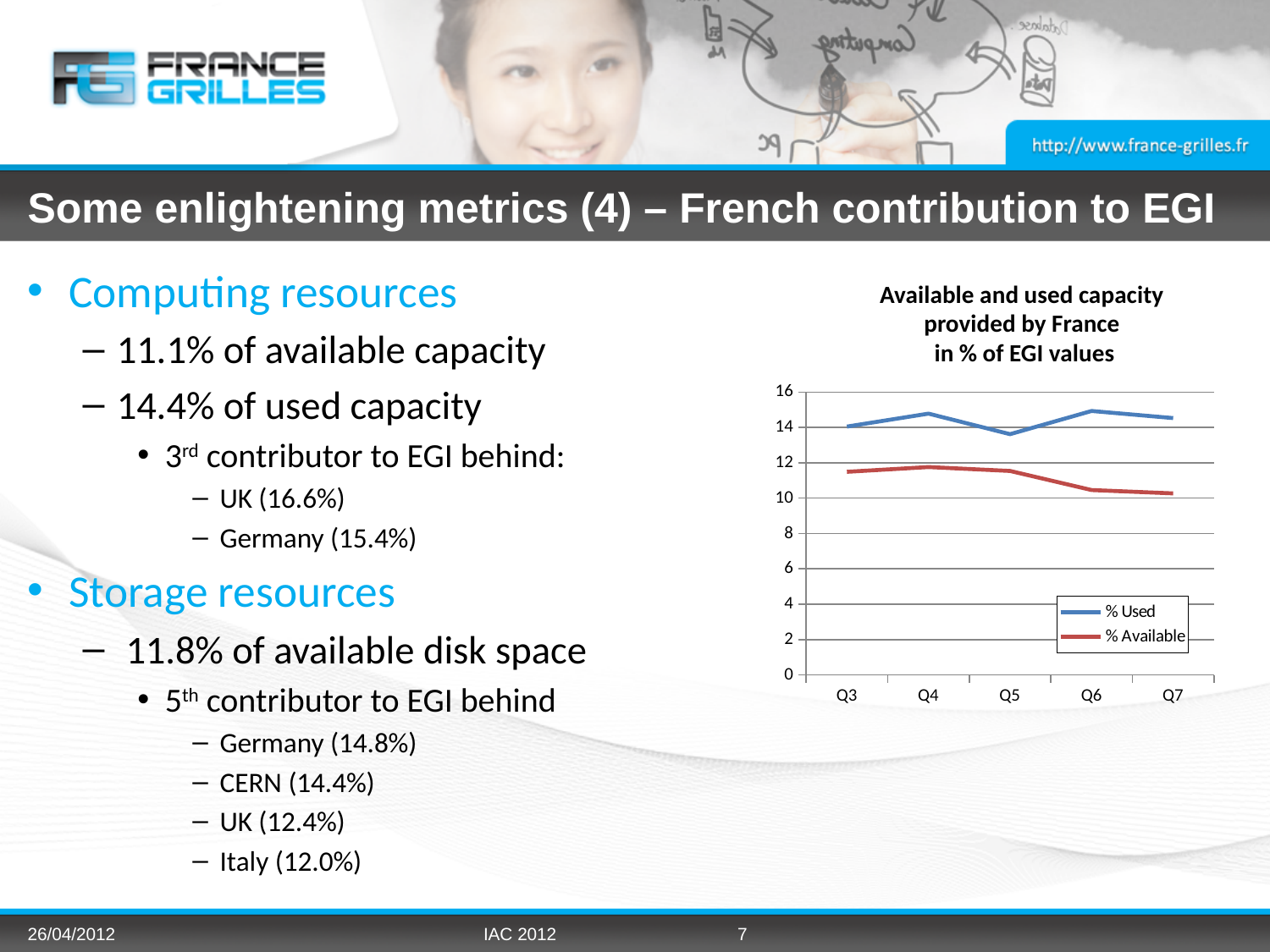
How many series does the chart legend list? 2 Is the value for % Used at Q5 greater or less than 12? greater Is the value for % Available at Q4 greater or less than 10? greater What kind of chart is shown on the slide? line chart What colour is the % Used line in the chart? blue How many quarters are plotted along the x axis of the chart? 5 Is the value for % Available at Q7 greater or less than 12? less What is the title of the chart? Available and used capacity provided by France in % of EGI values Does the % Available series rise or fall from Q5 to Q7? fall At Q5, which series has the larger value, % Used or % Available? % Used In which quarter is the % Used series at its lowest? Q5